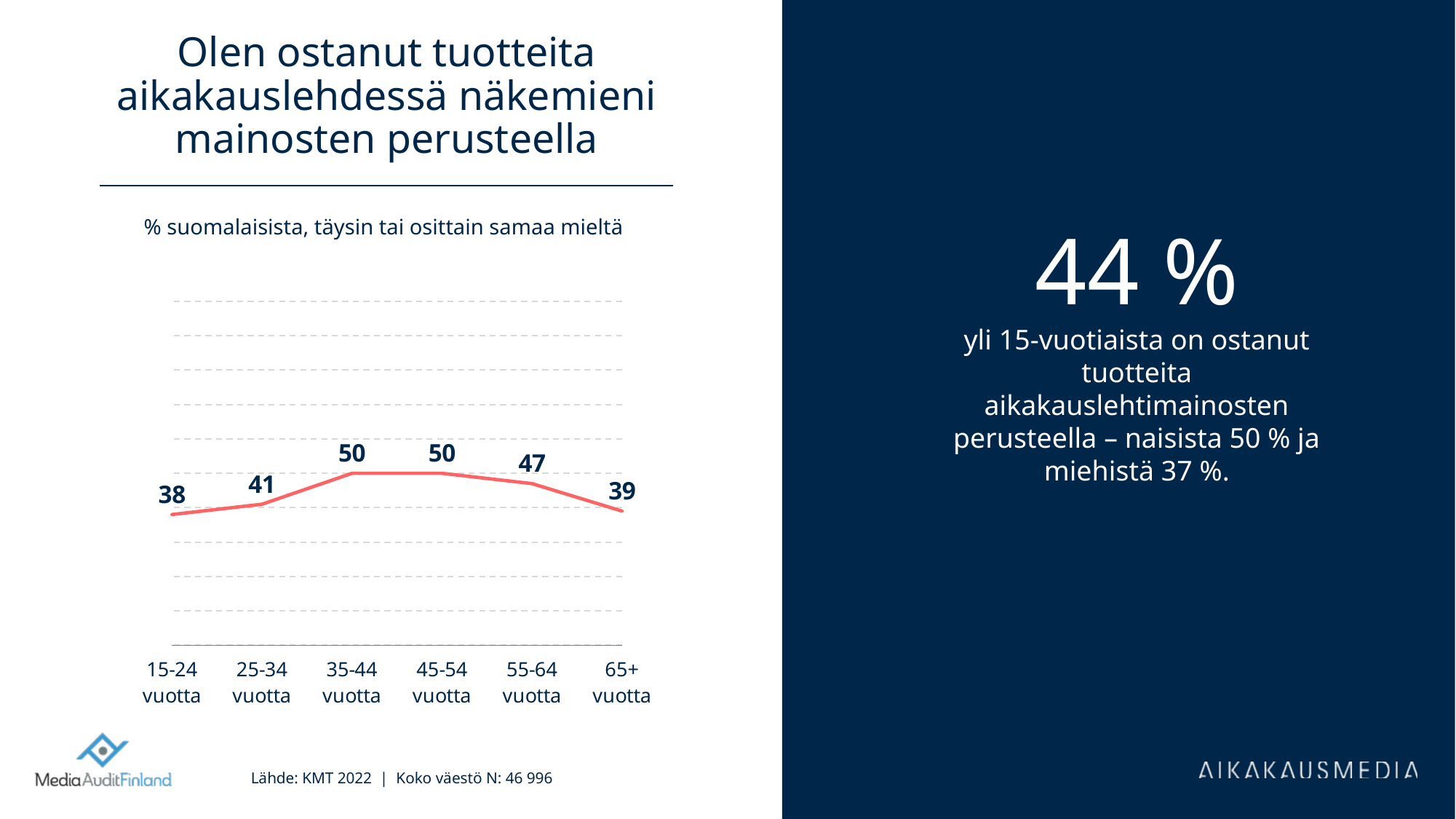
What is the value for the 15-24 vuotta age group? 38 What is the difference between the values for 35-44 vuotta and 15-24 vuotta? 12 What is the value for the 55-64 vuotta age group? 47 How many age groups are plotted on the chart? 6 Which age group has the lowest value? 15-24 vuotta What kind of chart is shown on the slide? Line chart What colour is the line on the chart? Red What is the difference between the values for 55-64 vuotta and 65+ vuotta? 8 Does the value rise or fall from 45-54 vuotta to 65+ vuotta? Fall What is the value for the 65+ vuotta age group? 39 What is the title of the chart? Olen ostanut tuotteita aikakauslehdessä näkemieni mainosten perusteella Which is larger, the value for 25-34 vuotta or the value for 65+ vuotta? 25-34 vuotta